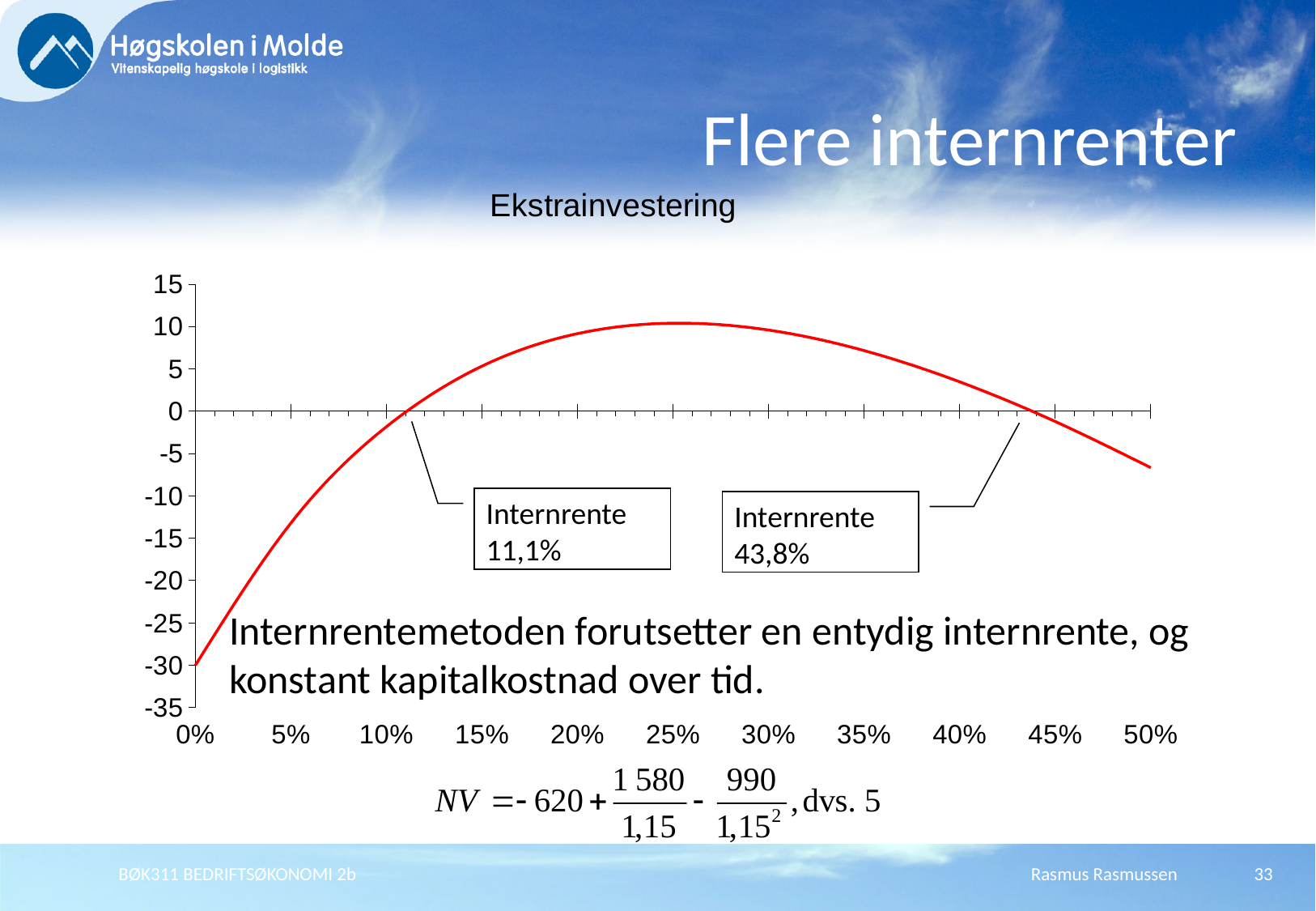
What kind of chart is shown on the slide? line chart What is the title of the chart? Ekstrainvestering Does the curve rise or fall between 35% and 50% on the x axis? fall How many internal rates (internrente) are annotated on the chart? 2 Is the value of the curve at 5% greater or less than 0? less What is the highest value labelled on the y axis? 15 Does the curve rise or fall between 0% and 20% on the x axis? rise What is the lower internal rate of return (internrente) marked on the chart? 11,1% What is the higher internal rate of return (internrente) marked on the chart? 43,8% Is the value of the curve at 50% greater or less than 0? less Is the value of the curve at 0% greater or less than -25? less